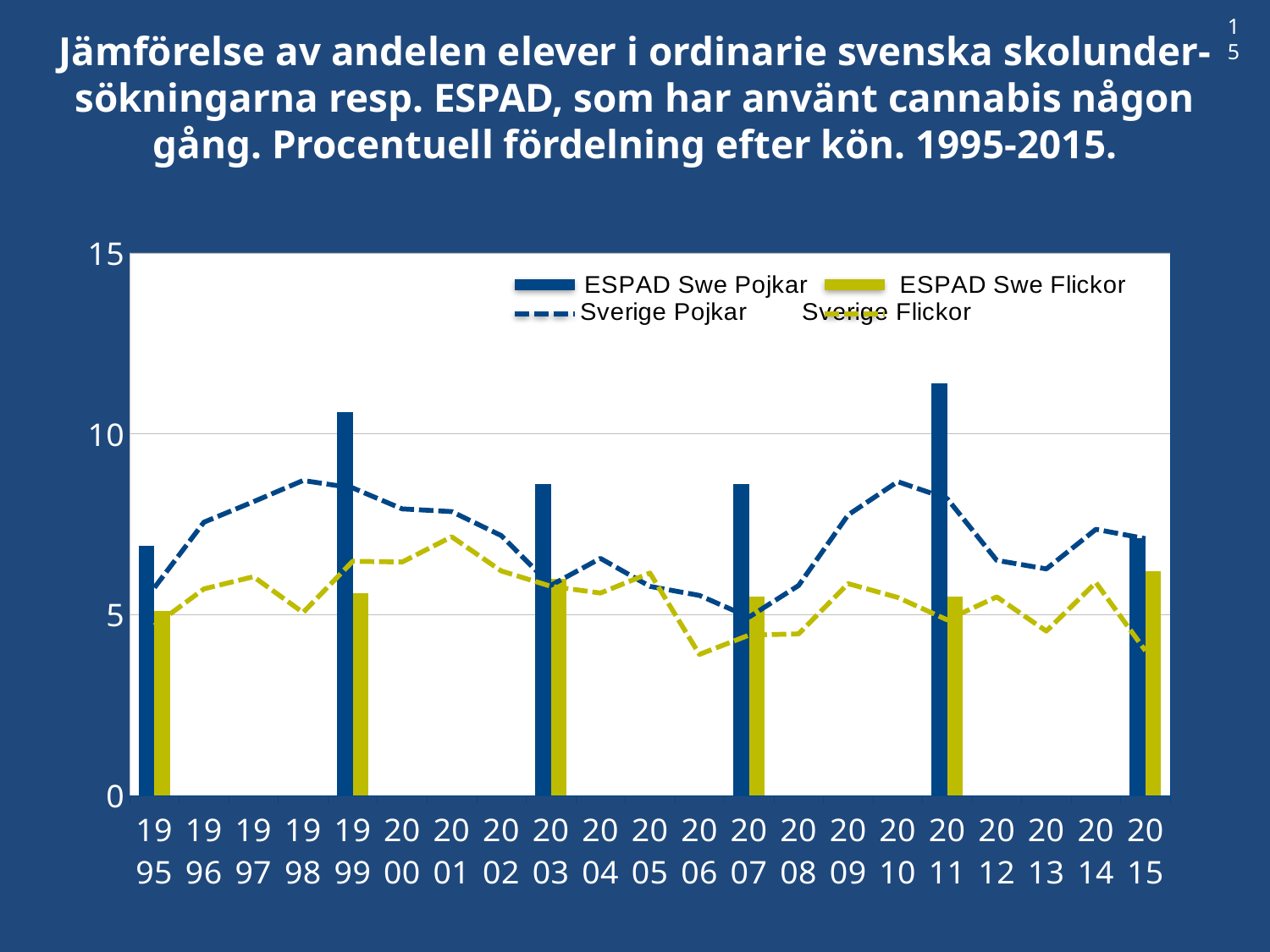
Is the value for Sverige Flickor in 2006 greater or less than 5? less How many series does the legend list? 4 In which year is the ESPAD Swe Pojkar bar highest? 2011 Which series is drawn as a dashed blue line? Sverige Pojkar What kind of chart is shown on the slide? A combined bar and line chart How many years are labelled along the x axis? 21 Is the value for ESPAD Swe Pojkar in 1995 greater or less than 10? less Is the value for ESPAD Swe Pojkar in 2011 greater or less than 10? greater In how many years are bars plotted for the ESPAD series? 6 Which is larger in 2011, the ESPAD Swe Pojkar bar or the ESPAD Swe Flickor bar? ESPAD Swe Pojkar Does the Sverige Pojkar line rise or fall from 1995 to 1998? Rise In which year is the ESPAD Swe Flickor bar lowest? 1995